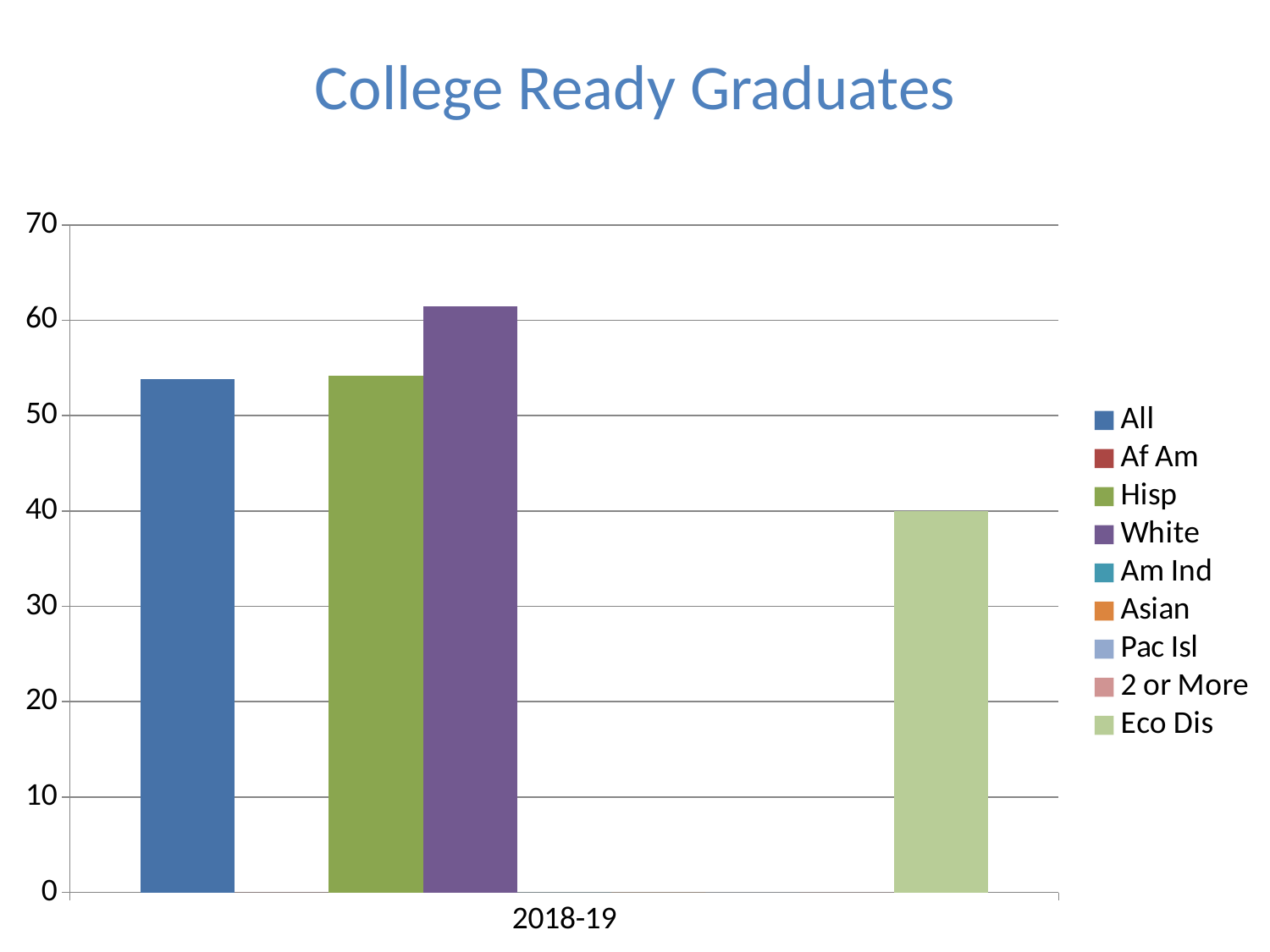
Which is larger, the value for White or the value for Eco Dis? White What is the label of the category on the x axis? 2018-19 What kind of chart is shown on the slide? bar chart How many categories are shown on the x axis? 1 Is the value for All greater or less than 50? greater Is the value for White greater or less than 60? greater Which series has the tallest bar in the chart? White How many series does the legend list? 9 What is the title of the chart? College Ready Graduates Which is larger, the value for Hisp or the value for Eco Dis? Hisp Is the value for Hisp greater or less than 60? less